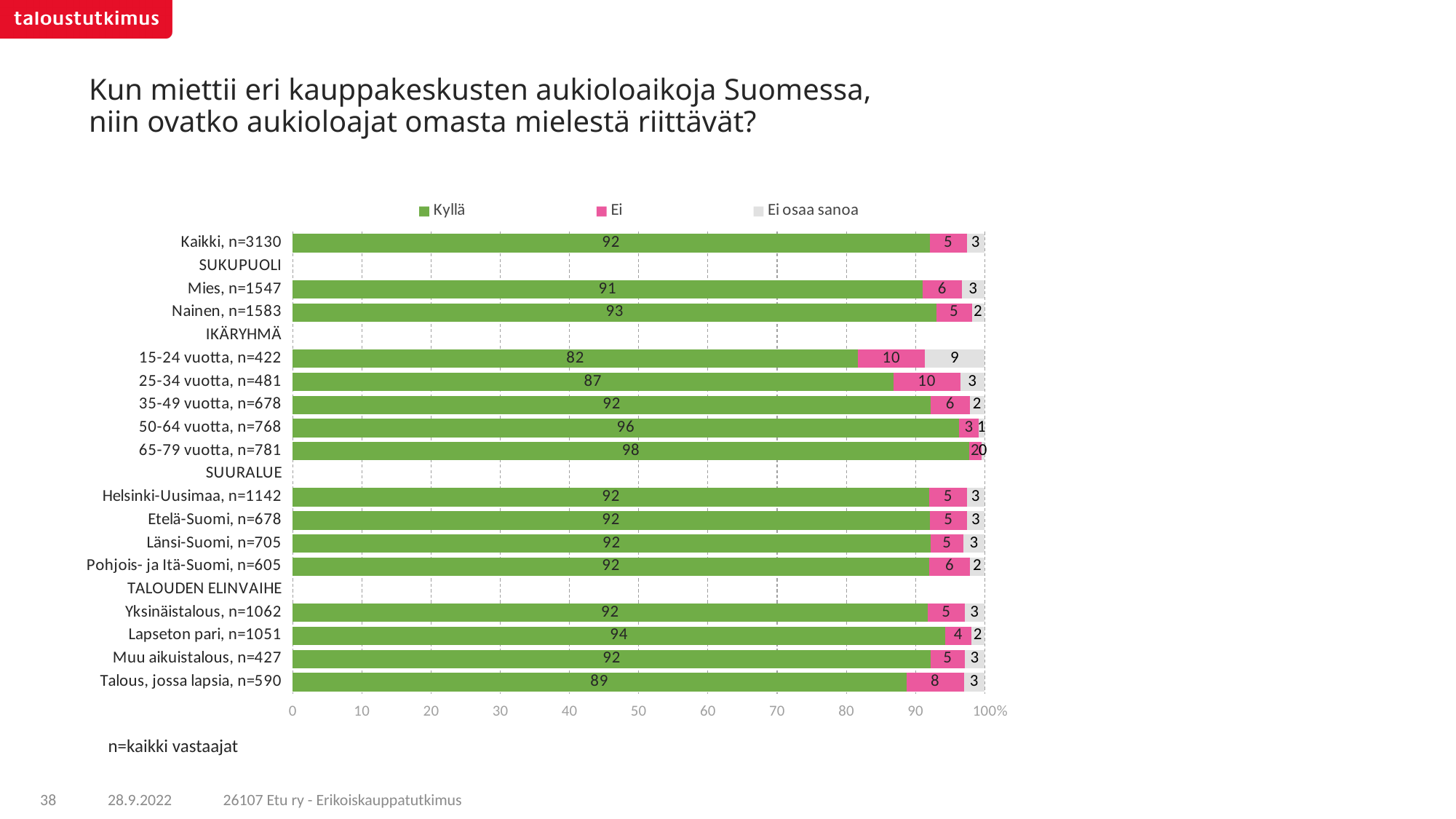
What percentage of all respondents (Kaikki, n=3130) answered Kyllä? 92 Which group has the lowest Kyllä value? 15-24 vuotta, n=422 What is the Ei value for the 15-24 vuotta, n=422 group? 10 How many age groups (IKÄRYHMÄ) are shown in the chart? 5 Which has a higher Kyllä value, Mies, n=1547 or Nainen, n=1583? Nainen, n=1583 What is the total of the stacked bar for Kaikki, n=3130? 100 What is the Ei value for Talous, jossa lapsia, n=590? 8 What is the Ei osaa sanoa value for the 15-24 vuotta, n=422 group? 9 What kind of chart is shown on the slide? Stacked bar chart How many series does the legend list? 3 Which group has the highest Kyllä value? 65-79 vuotta, n=781 What is the difference between the Kyllä values for 65-79 vuotta and 15-24 vuotta? 16